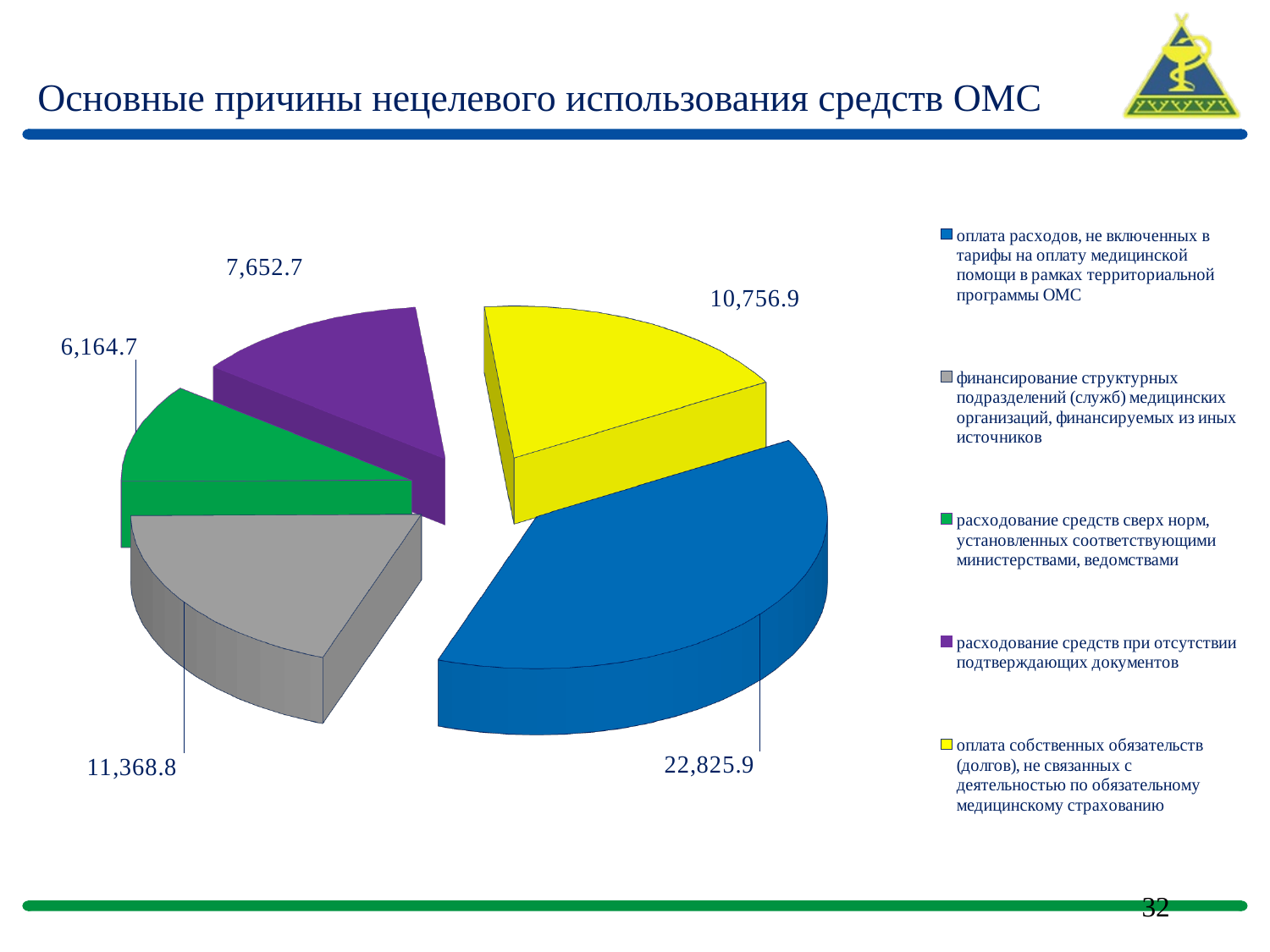
Which category has the largest slice in the pie chart? оплата расходов, не включенных в тарифы на оплату медицинской помощи в рамках территориальной программы ОМС What colour is the slice for 'расходование средств сверх норм, установленных соответствующими министерствами, ведомствами'? Green What is the total of all five slice values in the pie chart? 58,769.0 What is the value of the slice for 'оплата собственных обязательств (долгов), не связанных с деятельностью по обязательному медицинскому страхованию'? 10,756.9 What is the value of the slice for 'расходование средств при отсутствии подтверждающих документов'? 7,652.7 What type of chart is shown on the slide? Pie chart Which category has the smallest slice in the pie chart? расходование средств сверх норм, установленных соответствующими министерствами, ведомствами Which is larger: the slice for 'оплата собственных обязательств (долгов)...' or the slice for 'расходование средств при отсутствии подтверждающих документов'? оплата собственных обязательств (долгов), не связанных с деятельностью по обязательному медицинскому страхованию How many entries does the legend list? 5 What is the value of the slice for 'оплата расходов, не включенных в тарифы на оплату медицинской помощи в рамках территориальной программы ОМС'? 22,825.9 What is the difference between the largest slice (22,825.9) and the slice for 'финансирование структурных подразделений (служб) медицинских организаций, финансируемых из иных источников'? 11,457.1 How many slices does the pie chart have? 5